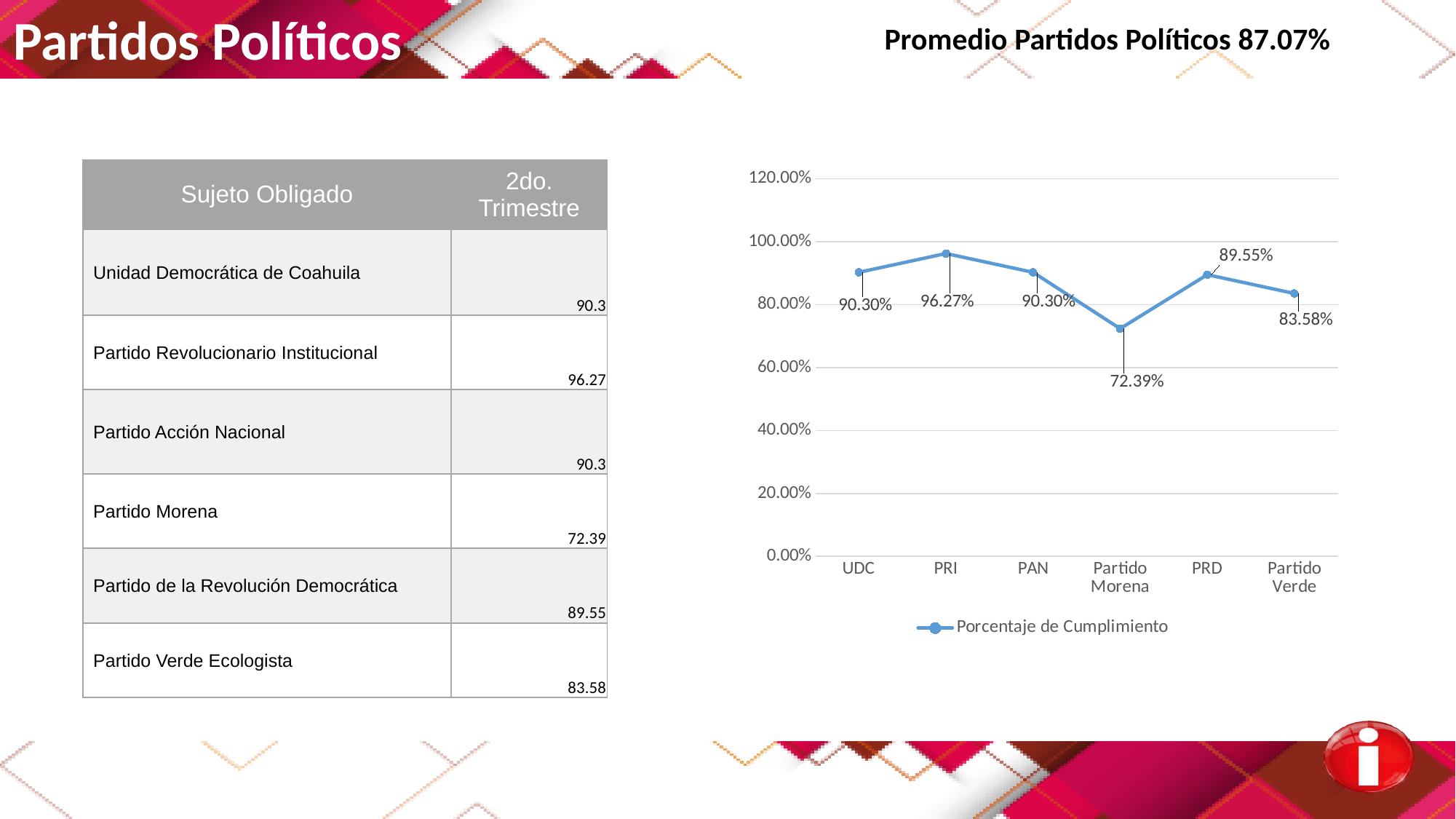
What kind of chart is shown on the slide? line chart What is the value for Partido Morena in the chart? 72.39% How many series does the chart legend list? 1 Which category has the highest value in the chart? PRI What is the value for PRI in the chart? 96.27% Is the value for Partido Morena greater or less than 80.00%? less Which category has the lowest value in the chart? Partido Morena Which is larger, the value for PRD or the value for Partido Verde? PRD What is the name of the series shown in the chart legend? Porcentaje de Cumplimiento What is the value for Partido Verde in the chart? 83.58% How many categories are plotted on the x axis of the chart? 6 What is the difference between the values for PRI and Partido Morena? 23.88%